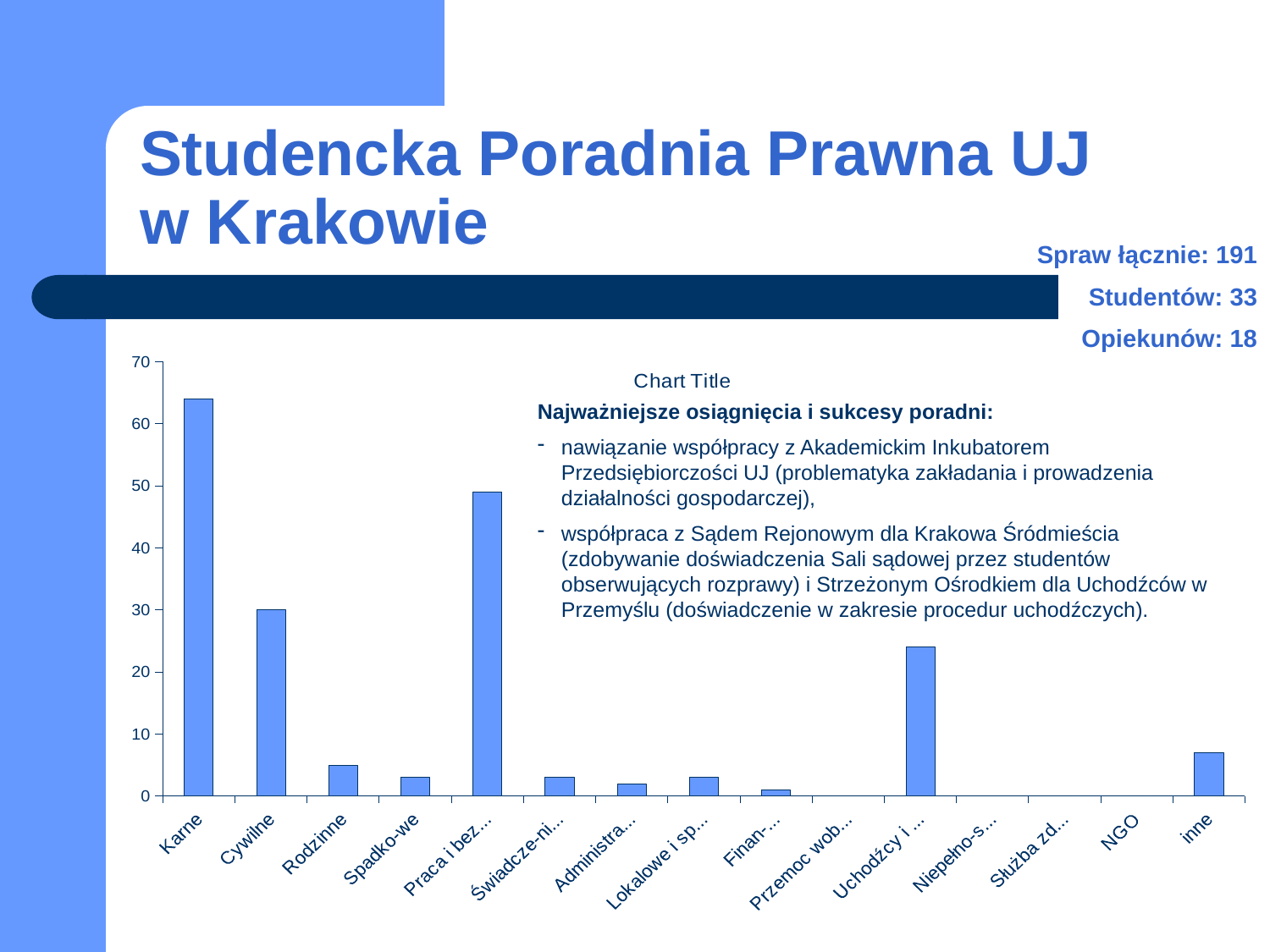
What is the title shown on the chart? Chart Title What kind of chart is shown on the slide? bar chart How many categories are shown on the x axis of the chart? 15 Is the value for Uchodźcy i ... greater or less than 20? greater Is the value for Karne greater or less than 60? greater Which is larger, the value for Karne or the value for Cywilne? Karne Which is larger, the value for NGO or the value for inne? inne What is the value for Cywilne? 30 Which is larger, the value for Rodzinne or the value for Spadko-we? Rodzinne Which category has the highest bar in the chart? Karne Is the value for inne greater or less than 10? less